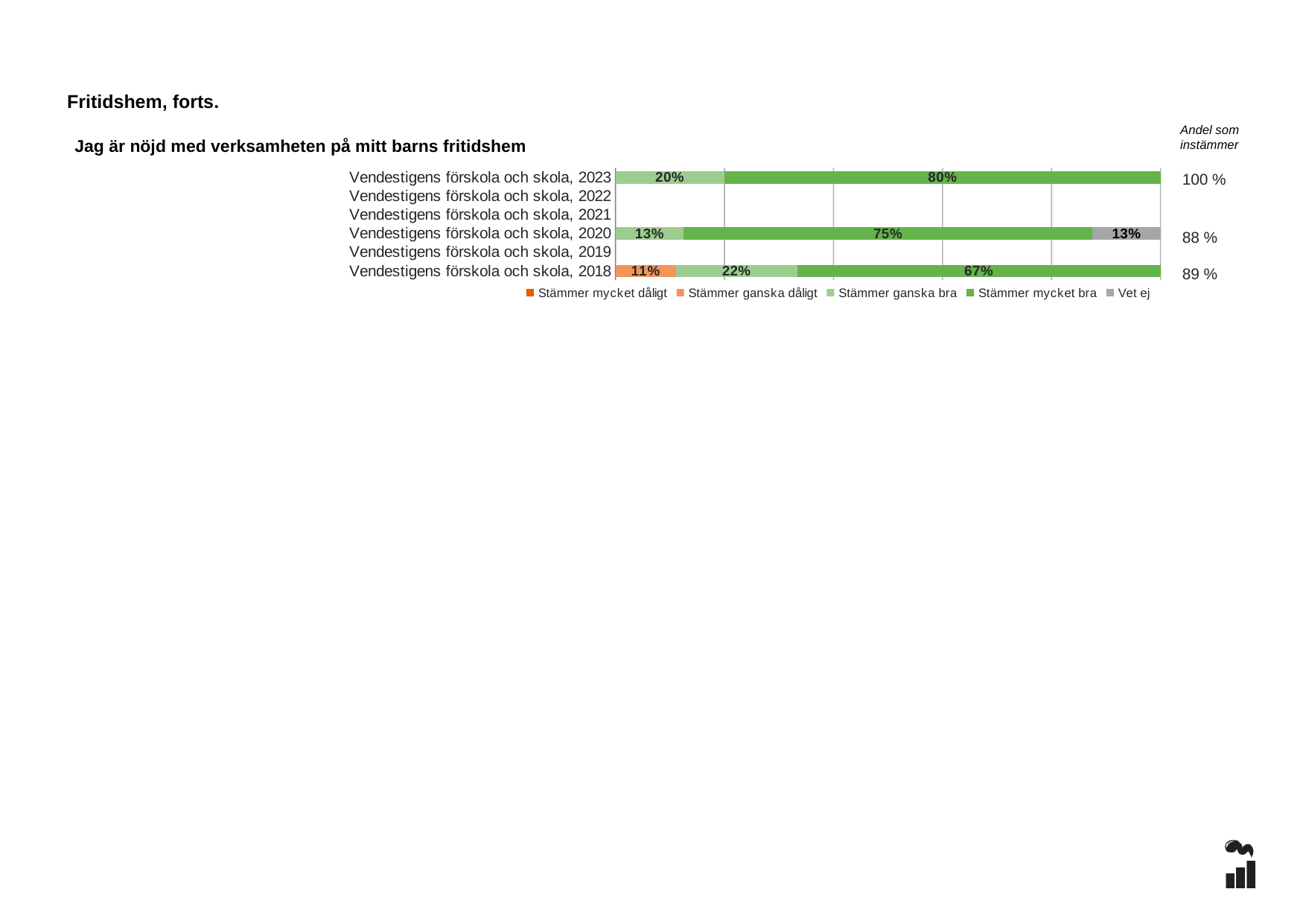
What is the difference between the "Stämmer mycket bra" values for 2023 and 2018? 13% Which year has the lowest "Stämmer mycket bra" value? Vendestigens förskola och skola, 2018 Is the "Stämmer ganska bra" value larger for 2018 or for 2020? 2018 What is the value for "Vet ej" for Vendestigens förskola och skola, 2020? 13% Which year has the highest "Stämmer mycket bra" value? Vendestigens förskola och skola, 2023 What kind of chart is shown on the slide? Stacked bar chart What is the value for "Stämmer ganska bra" for Vendestigens förskola och skola, 2020? 13% How many series does the legend list? 5 What is the value for "Stämmer mycket bra" for Vendestigens förskola och skola, 2023? 80% What is the value for "Stämmer ganska dåligt" for Vendestigens förskola och skola, 2018? 11% What is the total of the "Stämmer ganska bra" and "Stämmer mycket bra" segments for Vendestigens förskola och skola, 2020? 88% What is the "Andel som instämmer" value shown for Vendestigens förskola och skola, 2018? 89 %